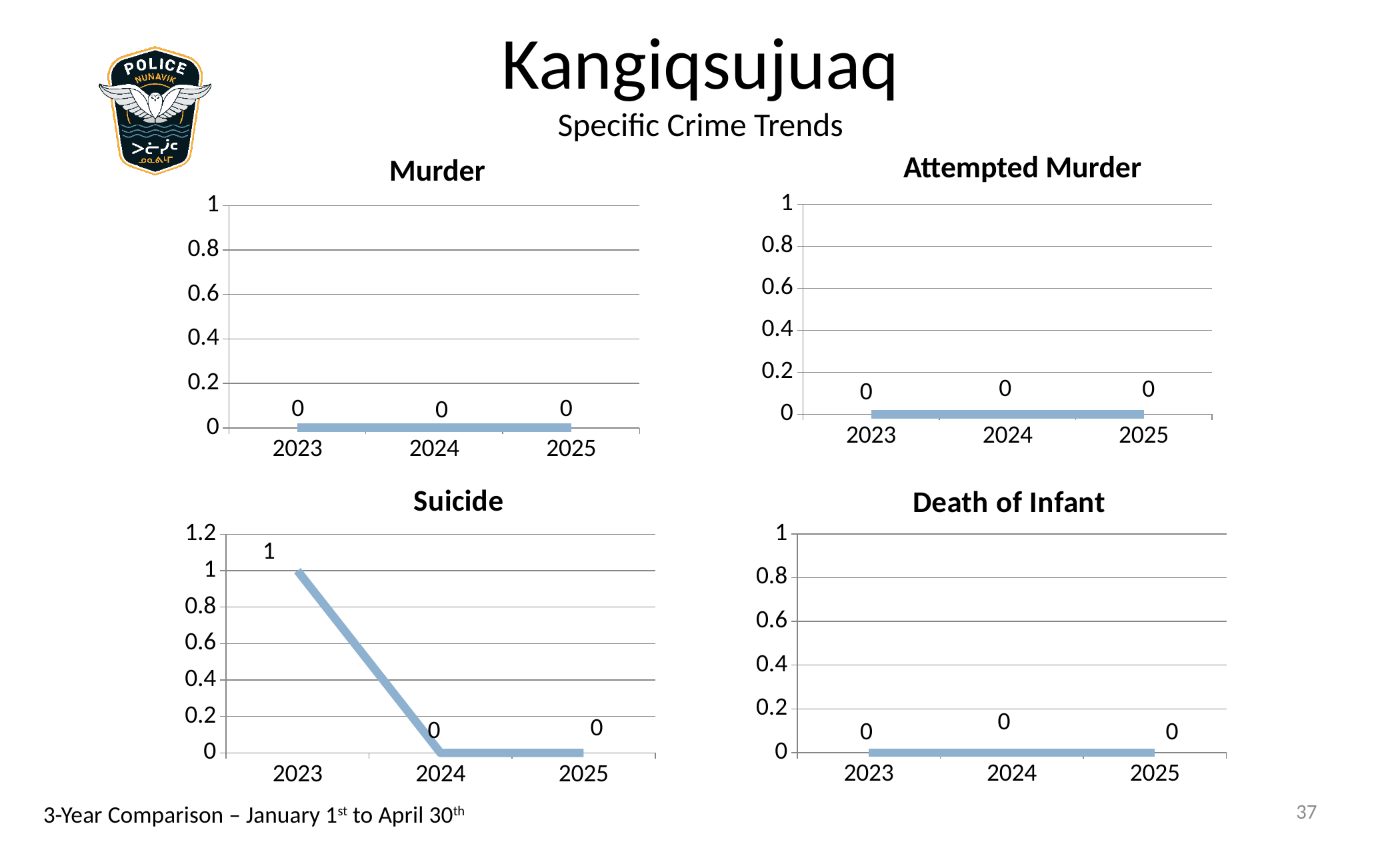
In the Suicide chart, do the values rise or fall from 2023 to 2025? fall In the Suicide chart, what is the difference between the 2023 and 2025 values? 1 How many years are plotted in the Murder chart? 3 In the Suicide chart, what is the value for 2023? 1 What kind of chart is the Suicide chart? line chart In the Suicide chart, what is the value for 2024? 0 In the Murder chart, what is the value for 2025? 0 In the Attempted Murder chart, what is the value for 2024? 0 In the Suicide chart, which year has the highest value? 2023 What is the title of the chart in the bottom right of the slide? Death of Infant In the Death of Infant chart, what is the value for 2023? 0 In the Suicide chart, which is larger, the value for 2023 or the value for 2024? 2023